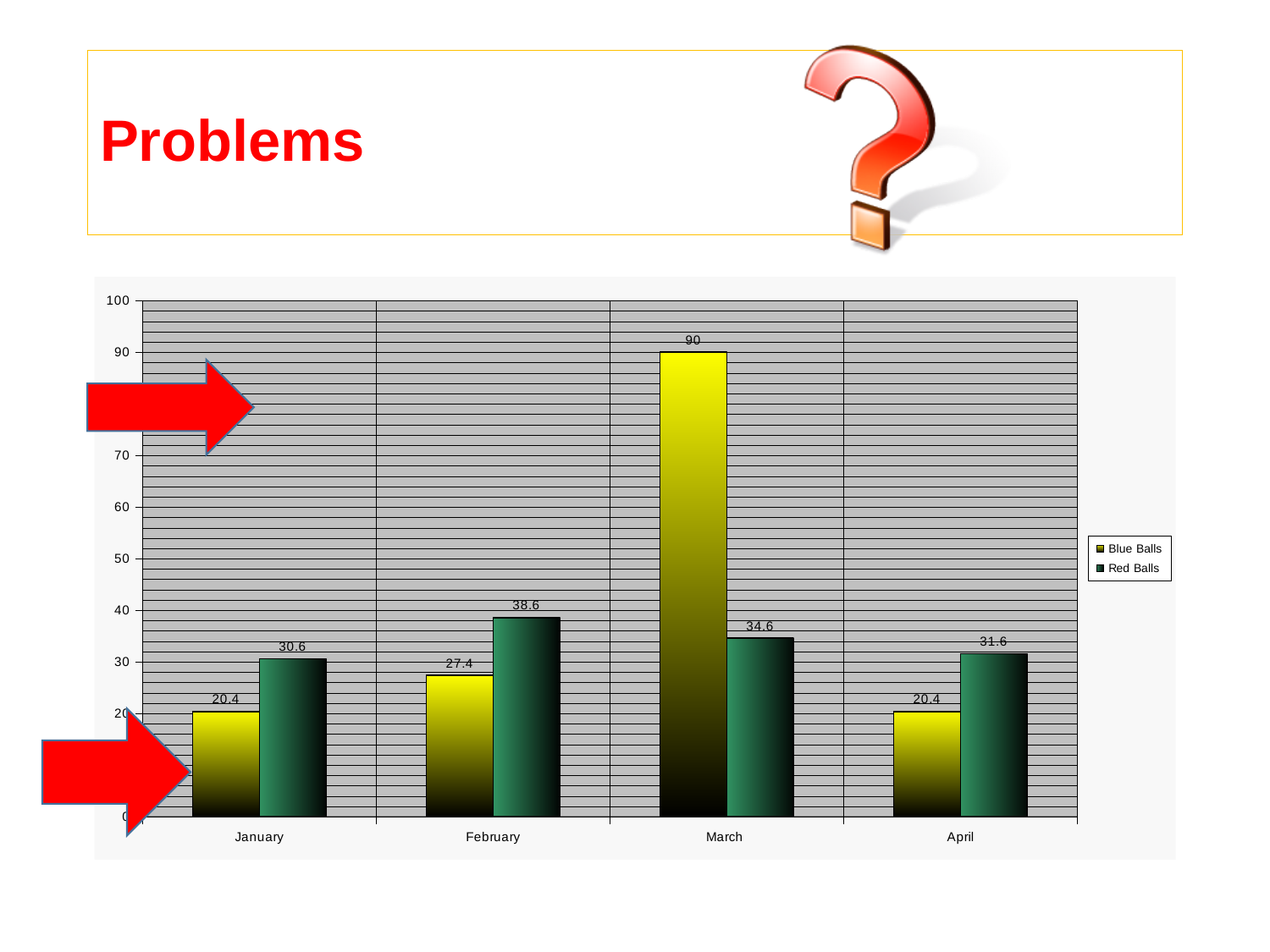
Which is larger in February, Blue Balls or Red Balls? Red Balls How many series does the legend list? 2 Which month has the lowest value for Red Balls? January What is the value for Blue Balls in March? 90 How many months are shown on the x axis? 4 Which month has the highest value for Red Balls? February What is the difference between Blue Balls and Red Balls in March? 55.4 What is the value for Red Balls in February? 38.6 Which month has the highest value for Blue Balls? March What is the value for Red Balls in April? 31.6 What kind of chart is shown on the slide? Bar chart What is the value for Blue Balls in January? 20.4